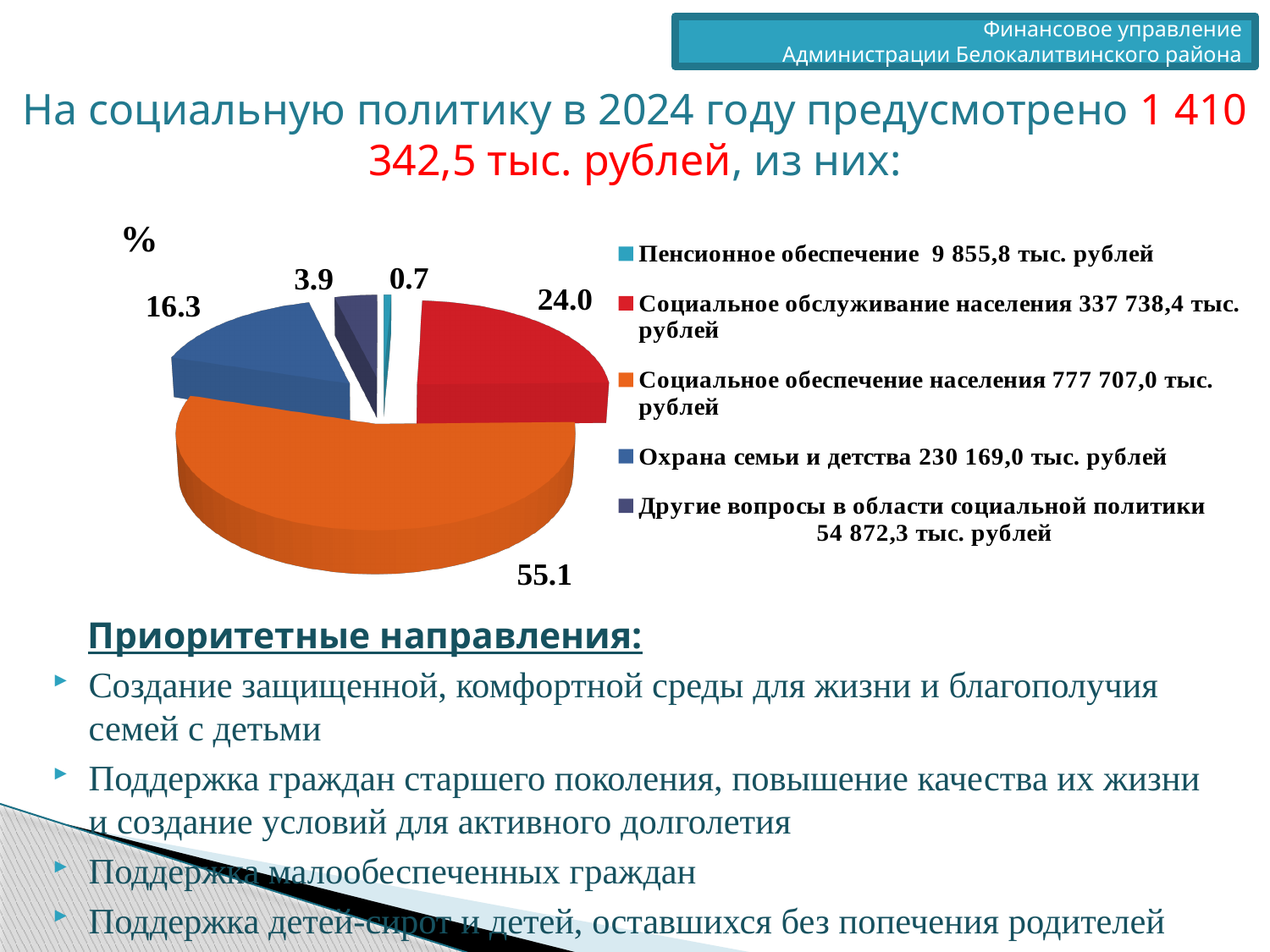
What percentage share does the slice for Другие вопросы в области социальной политики have? 3.9 What percentage share does the slice for Охрана семьи и детства have? 16.3 What percentage share does the slice for Социальное обеспечение населения have? 55.1 Which category has the smallest slice of the pie? Пенсионное обеспечение How many entries does the chart legend list? 5 Which slice is larger: Охрана семьи и детства or Другие вопросы в области социальной политики? Охрана семьи и детства Which category has the largest slice of the pie? Социальное обеспечение населения What percentage share does the slice for Пенсионное обеспечение have? 0.7 What is the difference in percentage points between the slices for Социальное обеспечение населения and Социальное обслуживание населения? 31.1 What kind of chart is shown on the slide? pie chart What percentage share does the slice for Социальное обслуживание населения have? 24.0 What amount in тыс. рублей does the legend give for Охрана семьи и детства? 230 169,0 тыс. рублей